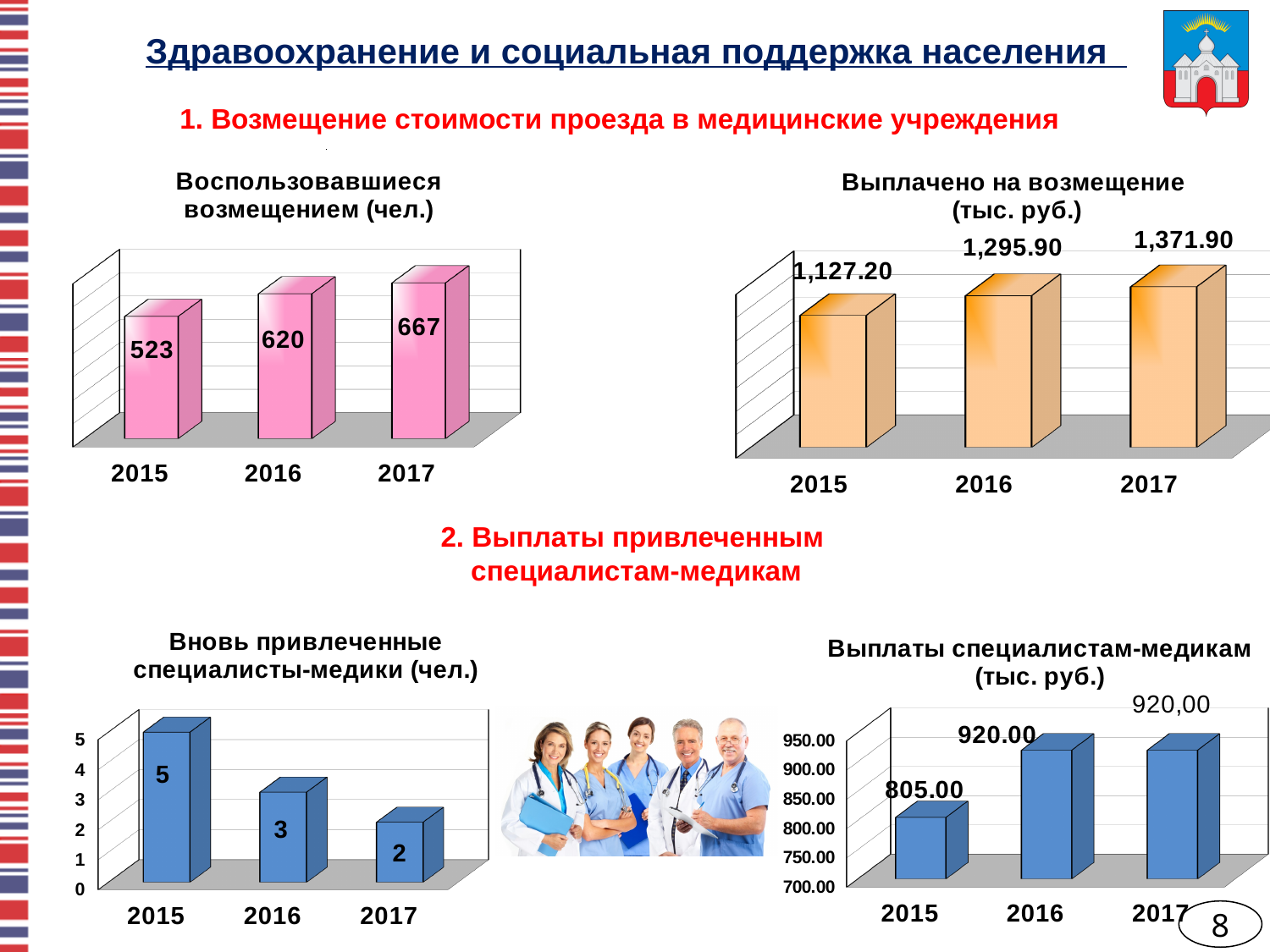
In the chart 'Воспользовавшиеся возмещением (чел.)', which year has the lowest value? 2015 In the chart 'Вновь привлеченные специалисты-медики (чел.)', how many years are shown? 3 In the chart 'Воспользовавшиеся возмещением (чел.)', what is the difference between the 2017 and 2015 values? 144 In the chart 'Выплаты специалистам-медикам (тыс. руб.)', is the value for 2016 greater or less than 900.00? greater In the chart 'Выплачено на возмещение (тыс. руб.)', do the values rise or fall from 2015 to 2017? rise In the chart 'Воспользовавшиеся возмещением (чел.)', what is the value for 2016? 620 In the chart 'Вновь привлеченные специалисты-медики (чел.)', what is the value for 2015? 5 What type of chart is 'Выплаты специалистам-медикам (тыс. руб.)'? bar chart In the chart 'Выплаты специалистам-медикам (тыс. руб.)', what is the value for 2015? 805.00 In the chart 'Выплачено на возмещение (тыс. руб.)', what is the value for 2017? 1,371.90 In the chart 'Вновь привлеченные специалисты-медики (чел.)', do the values rise or fall from 2015 to 2017? fall In the chart 'Выплачено на возмещение (тыс. руб.)', which year has the highest value? 2017